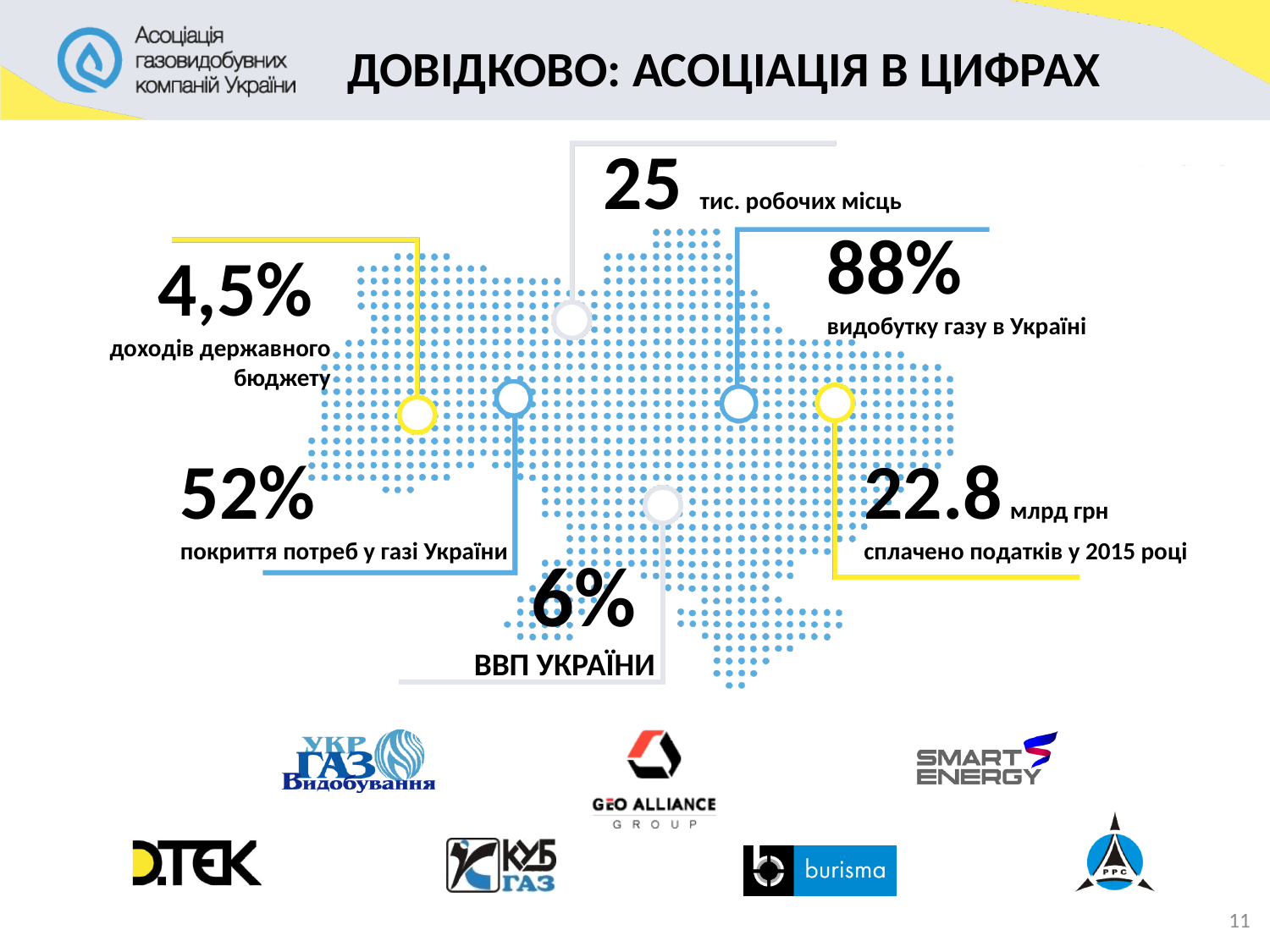
What share of Ukraine's gas needs is covered by the association's members, according to the infographic? 52% What is the title of the slide? ДОВІДКОВО: АСОЦІАЦІЯ В ЦИФРАХ How much tax was paid in 2015 according to the infographic? 22.8 млрд грн Which is larger on the infographic: the share of gas production in Ukraine or the share of coverage of Ukraine's gas needs? share of gas production (88%) How many numbered callouts are placed on the map of Ukraine? 6 What share of Ukraine's GDP (ВВП України) is shown on the infographic? 6% What share of state budget revenues (доходів державного бюджету) is shown on the infographic? 4,5% What is the difference between the share of gas production in Ukraine (88%) and the share of coverage of Ukraine's gas needs (52%)? 36% Which is larger: the share of Ukraine's GDP or the share of state budget revenues shown on the infographic? share of Ukraine's GDP (6%) What kind of visual is used on the slide to present the figures? a dotted map of Ukraine with callouts (infographic) What share of Ukraine's gas production do the association's members account for, according to the infographic? 88% How many jobs (тис. робочих місць) does the infographic attribute to the association? 25 тис.